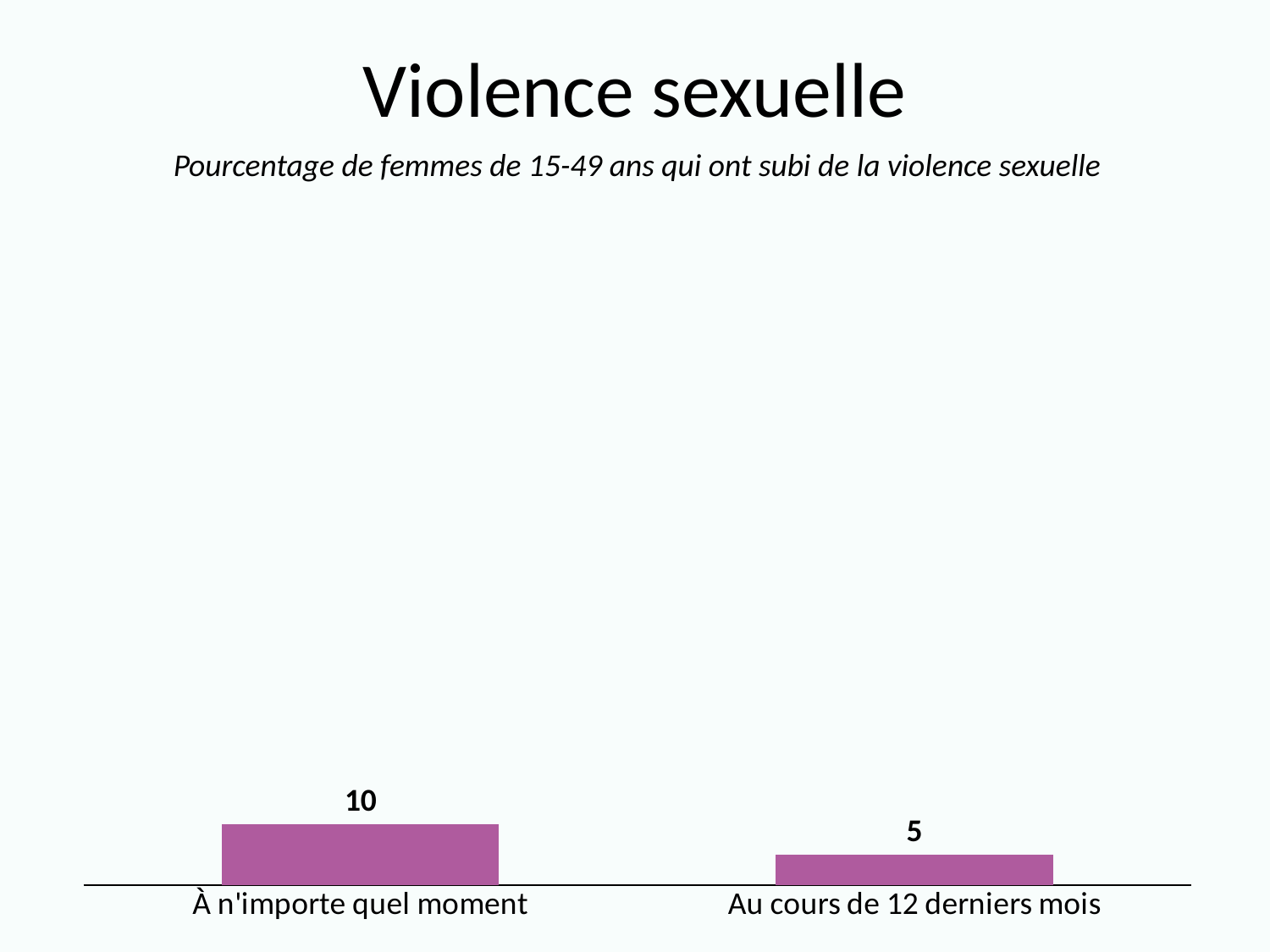
What kind of chart is shown on the slide? Bar chart What is the difference between the values for "À n'importe quel moment" and "Au cours de 12 derniers mois"? 5 What colour are the bars on the chart? Purple What is the value for "À n'importe quel moment"? 10 Which category has the highest value? À n'importe quel moment How many categories are shown on the chart? 2 Which is larger: the value for "À n'importe quel moment" or for "Au cours de 12 derniers mois"? À n'importe quel moment Which category has the lowest value? Au cours de 12 derniers mois What is the title of the slide? Violence sexuelle Do the values rise or fall from left to right across the categories? Fall What is the value for "Au cours de 12 derniers mois"? 5